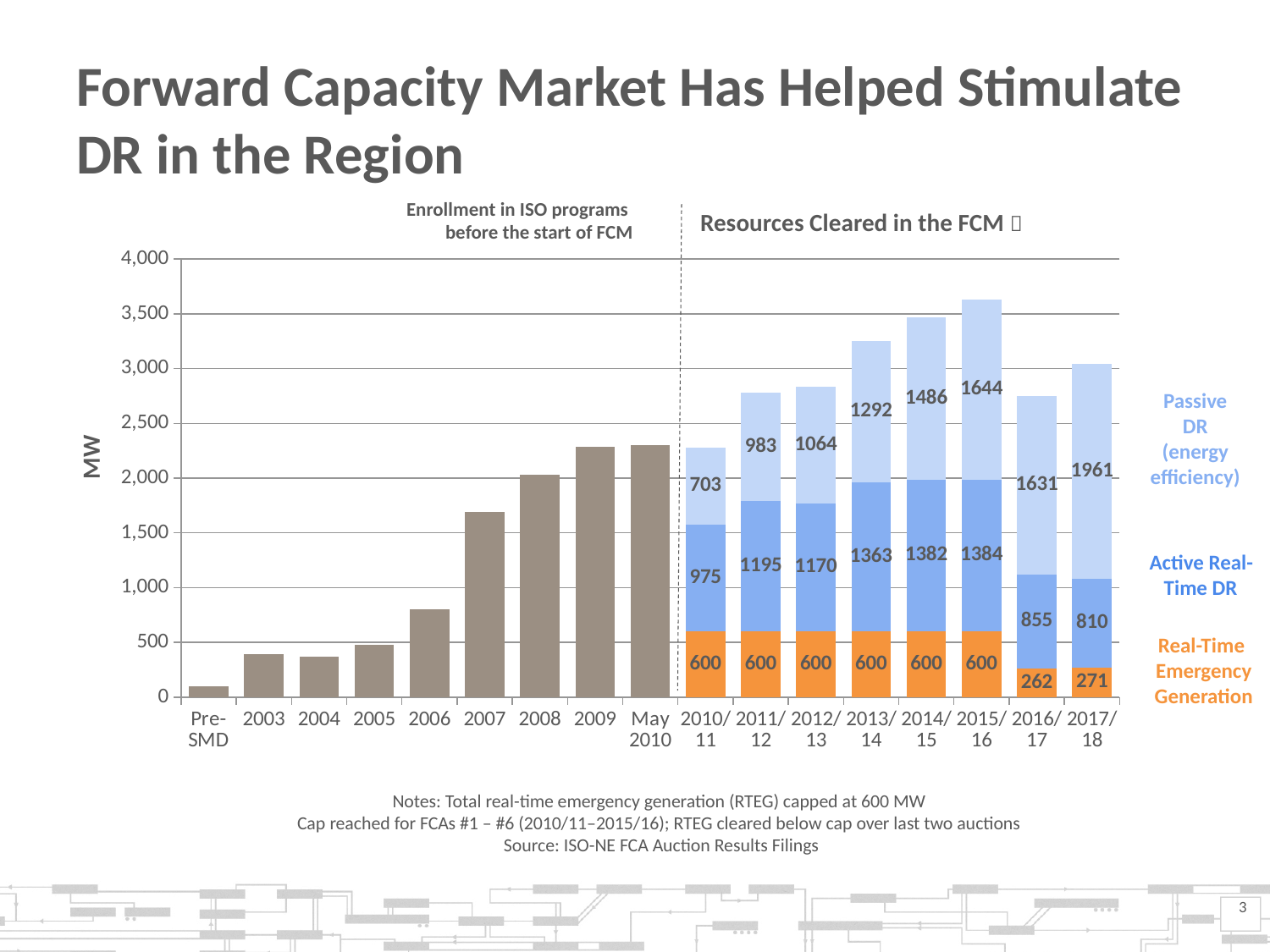
Which auction year has the lowest Real-Time Emergency Generation value? 2016/17 What is the total of the stacked bar for 2010/11? 2278 Is the value for 2007 greater or less than 1,500? greater Do the values rise or fall from Pre-SMD to May 2010? rise Which has the larger Active Real-Time DR value, 2012/13 or 2013/14? 2013/14 What kind of chart is shown on the slide? bar chart Which auction year has the highest Passive DR (energy efficiency) value? 2017/18 What is the Active Real-Time DR value for 2011/12? 1195 What is the Passive DR (energy efficiency) value for 2015/16? 1644 What is the difference between the Passive DR values for 2017/18 and 2016/17? 330 Is the value for 2006 greater or less than 1,000? less What is the Real-Time Emergency Generation value for 2016/17? 262